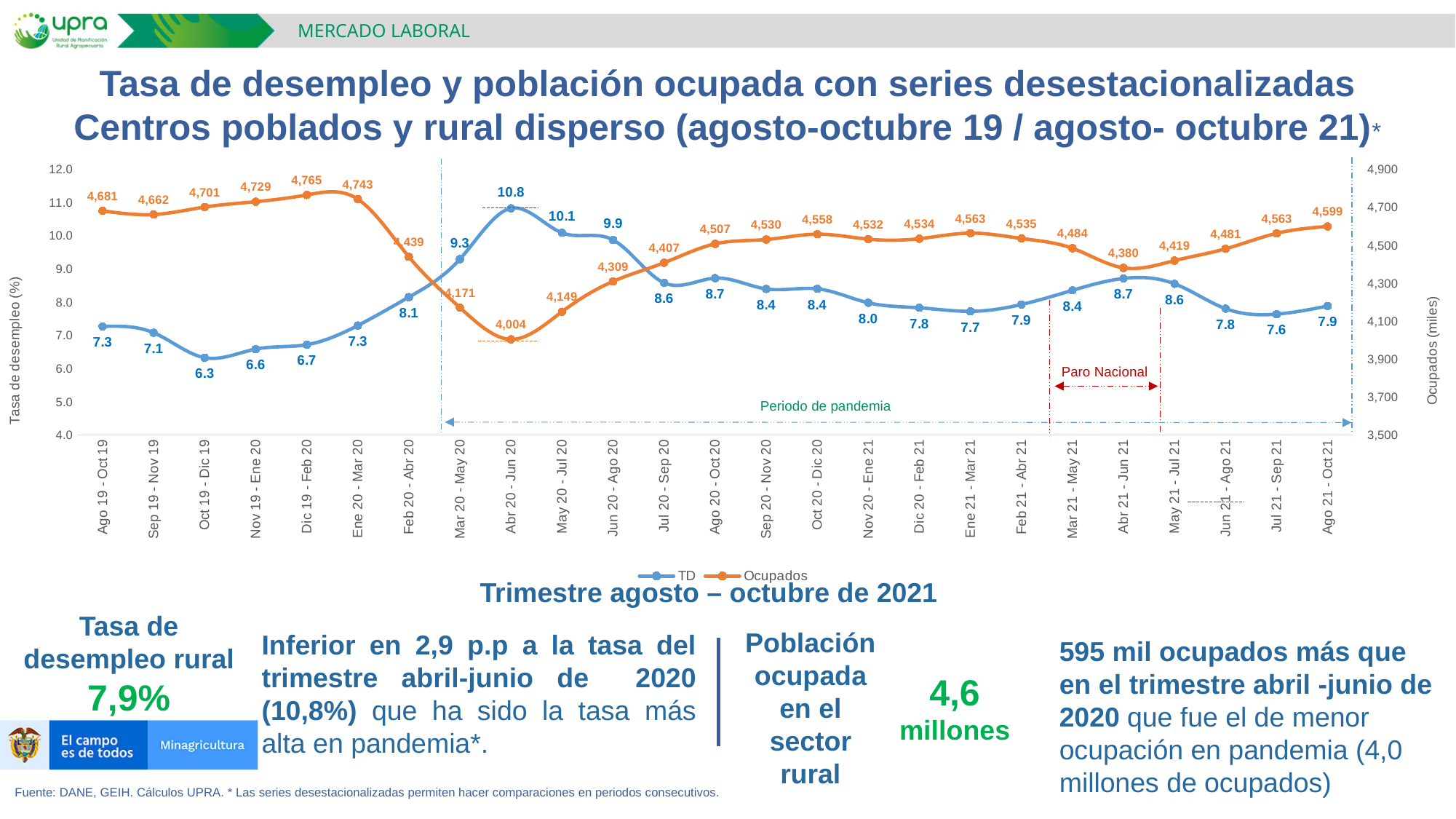
What is the Ocupados value for Ago 21 - Oct 21? 4,599 What type of chart is shown on the slide? Line chart What is the Ocupados value for Dic 19 - Feb 20? 4,765 What is the difference between the TD value for Abr 20 - Jun 20 and the TD value for Ago 21 - Oct 21? 2.9 Which is larger, the Ocupados value for Ene 21 - Mar 21 or for Abr 21 - Jun 21? Ene 21 - Mar 21 In which period does the TD series reach its highest value? Abr 20 - Jun 20 In which period does the TD series reach its lowest value? Oct 19 - Dic 19 How many periods are shown on the x axis of the chart? 25 What is the difference between the Ocupados value for Ago 21 - Oct 21 and the Ocupados value for Abr 20 - Jun 20? 595 What is the TD value for Abr 20 - Jun 20? 10.8 How many series does the chart legend list? 2 In which period does the Ocupados series reach its lowest value? Abr 20 - Jun 20